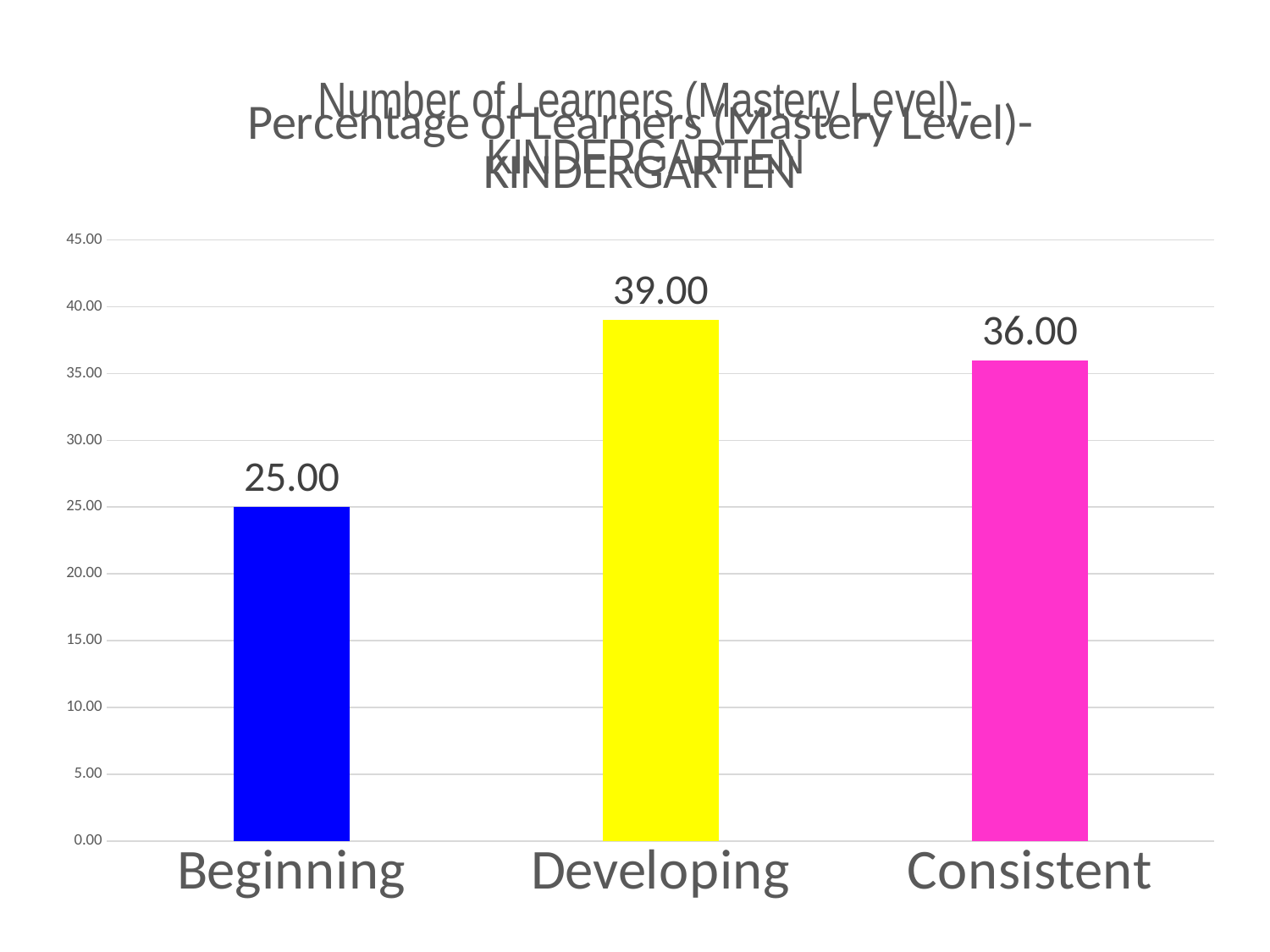
Which category has the highest value? Developing Which is larger, the value for Consistent or the value for Beginning? Consistent What colour is the bar for Developing? yellow What is the value for Consistent? 36.00 What is the value for Beginning? 25.00 How many categories are shown on the x axis? 3 What is the value for Developing? 39.00 Which category has the lowest value? Beginning What is the difference between the values for Developing and Consistent? 3.00 Is the value for Consistent greater or less than 30.00? greater What kind of chart is shown on the slide? bar chart What is the difference between the values for Developing and Beginning? 14.00